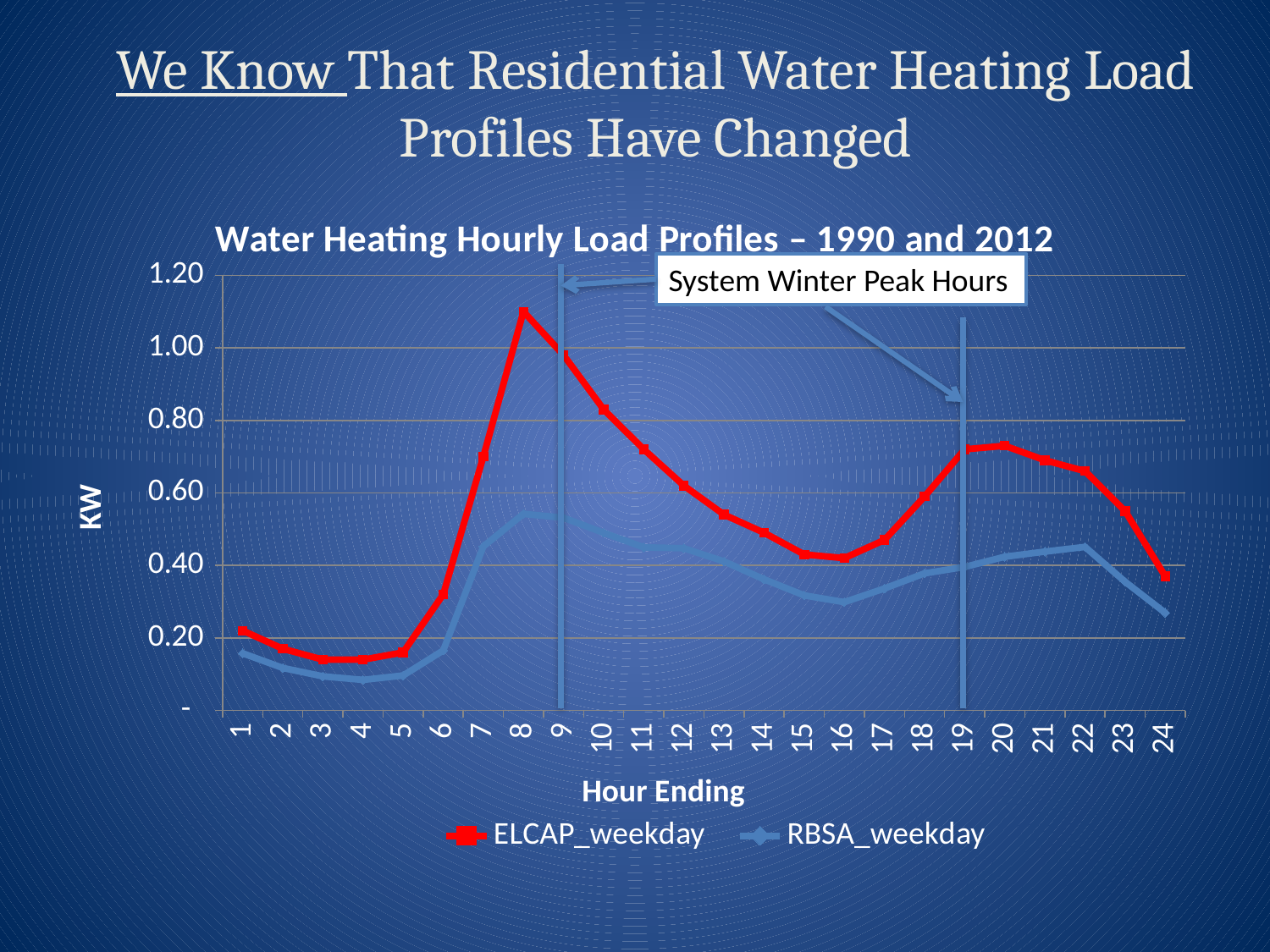
Is the ELCAP_weekday value at hour ending 20 greater or less than 0.60 KW? greater Is the RBSA_weekday value at hour ending 24 greater or less than 0.40 KW? less Is the ELCAP_weekday value at hour ending 16 greater or less than 0.60 KW? less What kind of chart is shown on the slide? line chart At which hour ending does the RBSA_weekday series reach its highest value? 8 At which hour ending does the ELCAP_weekday series reach its highest value? 8 How many hours are plotted along the x axis of the chart? 24 How many series does the chart legend list? 2 Does the ELCAP_weekday series rise or fall between hour ending 8 and hour ending 16? fall What is the label on the vertical axis of the chart? KW At hour ending 8, which series has the larger value, ELCAP_weekday or RBSA_weekday? ELCAP_weekday